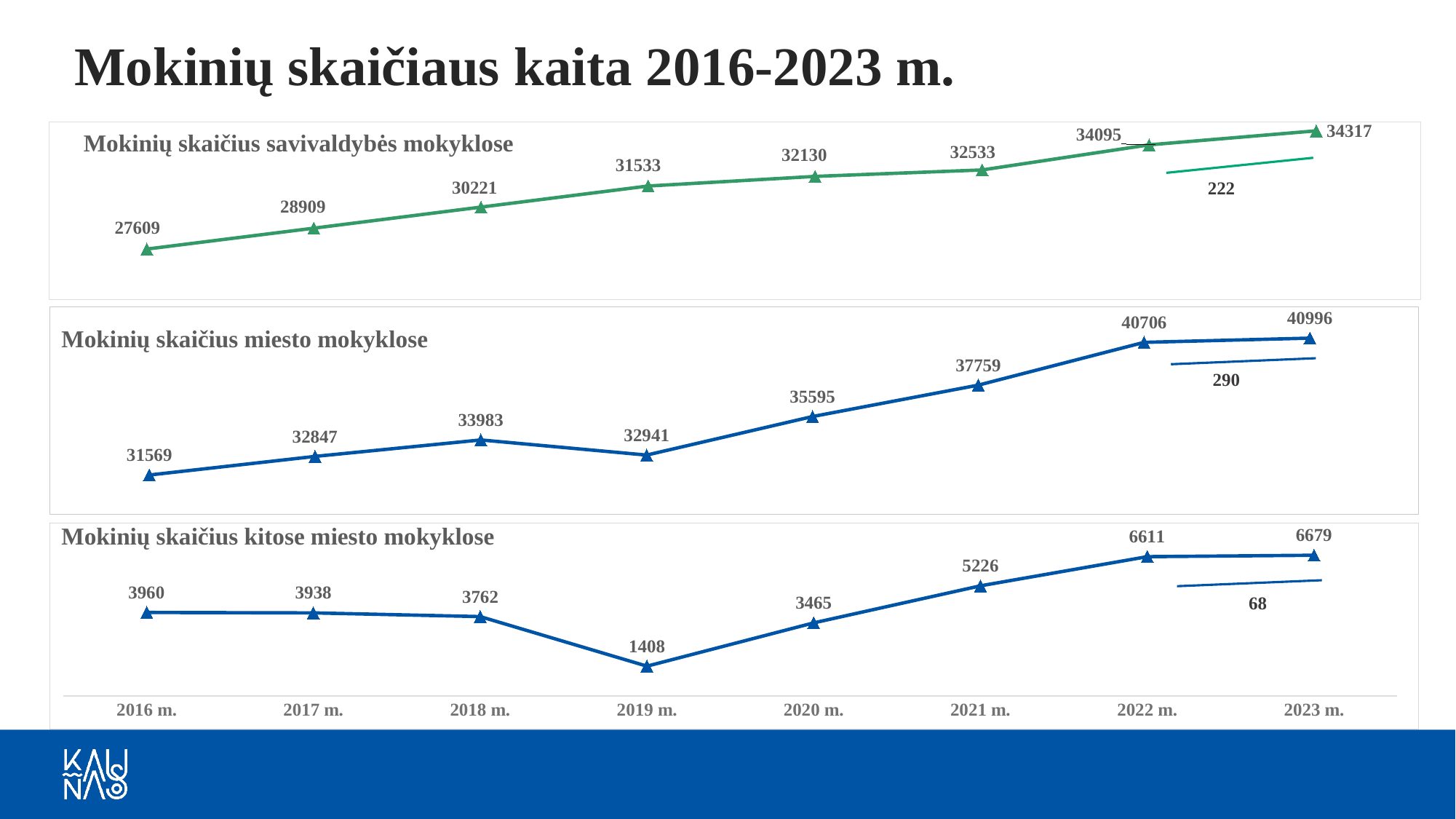
In the chart 'Mokinių skaičius kitose miesto mokyklose', which year has the highest value? 2023 m. In the chart 'Mokinių skaičius miesto mokyklose', what is the value for 2020 m.? 35595 In the chart 'Mokinių skaičius savivaldybės mokyklose', do the values rise or fall from 2016 m. to 2023 m.? rise What kind of chart is 'Mokinių skaičius savivaldybės mokyklose'? line chart In the chart 'Mokinių skaičius miesto mokyklose', which year has the lowest value? 2016 m. In the chart 'Mokinių skaičius kitose miesto mokyklose', what is the difference between the 2022 m. and 2021 m. values? 1385 In the chart 'Mokinių skaičius miesto mokyklose', which is larger, the value for 2018 m. or 2019 m.? 2018 m. In the chart 'Mokinių skaičius savivaldybės mokyklose', what is the value for 2016 m.? 27609 In the chart 'Mokinių skaičius savivaldybės mokyklose', what is the value for 2023 m.? 34317 In the chart 'Mokinių skaičius savivaldybės mokyklose', what is the difference between the 2023 m. and 2022 m. values? 222 How many years are plotted on the x axis of the bottom chart? 8 In the chart 'Mokinių skaičius kitose miesto mokyklose', what is the value for 2019 m.? 1408